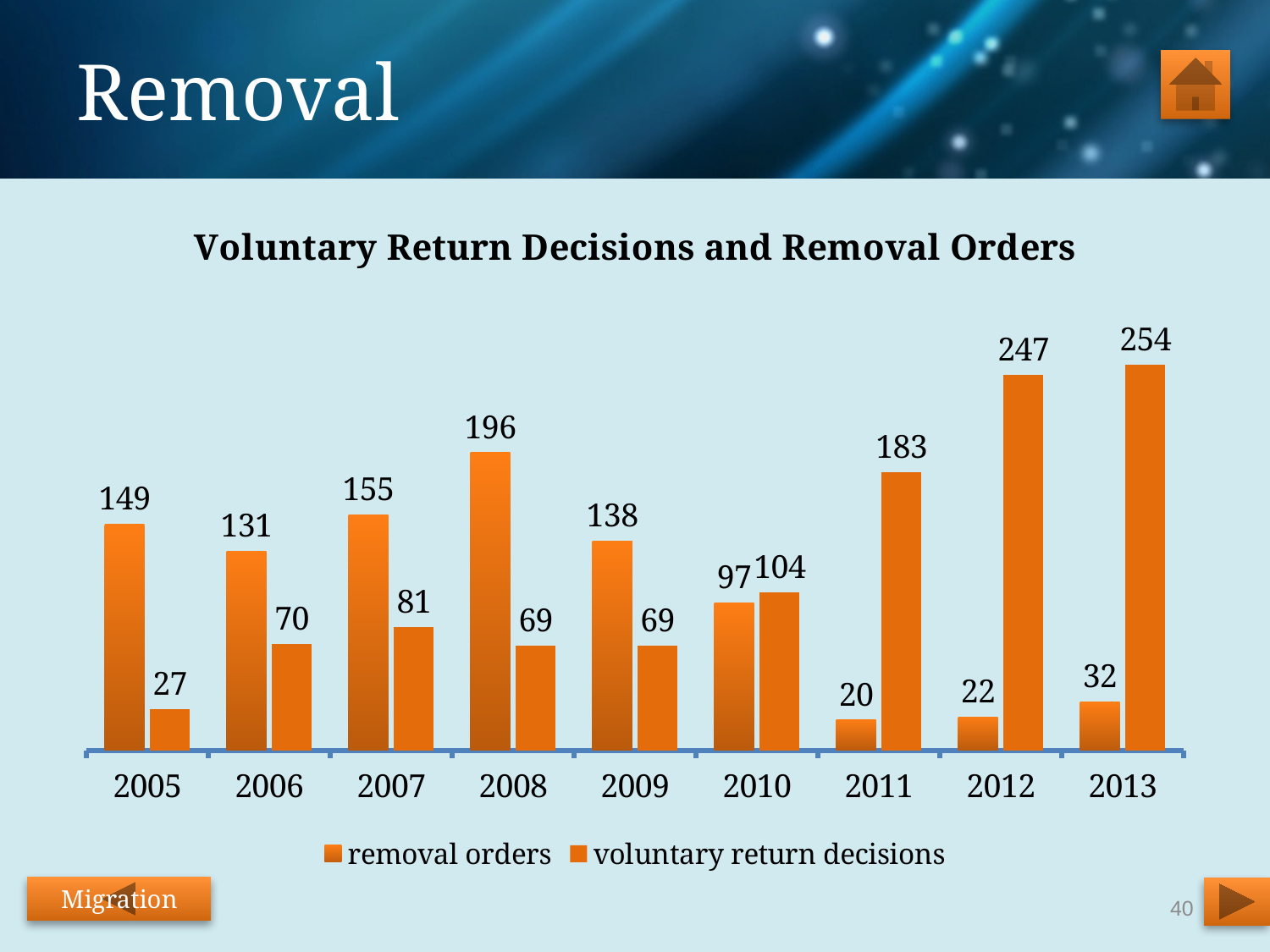
In which year are voluntary return decisions highest? 2013 What kind of chart is shown on the slide? bar chart What is the difference between removal orders and voluntary return decisions in 2005? 122 Which is larger in 2010, removal orders or voluntary return decisions? voluntary return decisions What is the title of the chart? Voluntary Return Decisions and Removal Orders In which year are removal orders lowest? 2011 Do voluntary return decisions rise or fall from 2010 to 2013? rise How many years are shown on the x axis? 9 How many series does the legend list? 2 What is the value of removal orders in 2011? 20 What is the value of removal orders in 2008? 196 What is the value of voluntary return decisions in 2012? 247